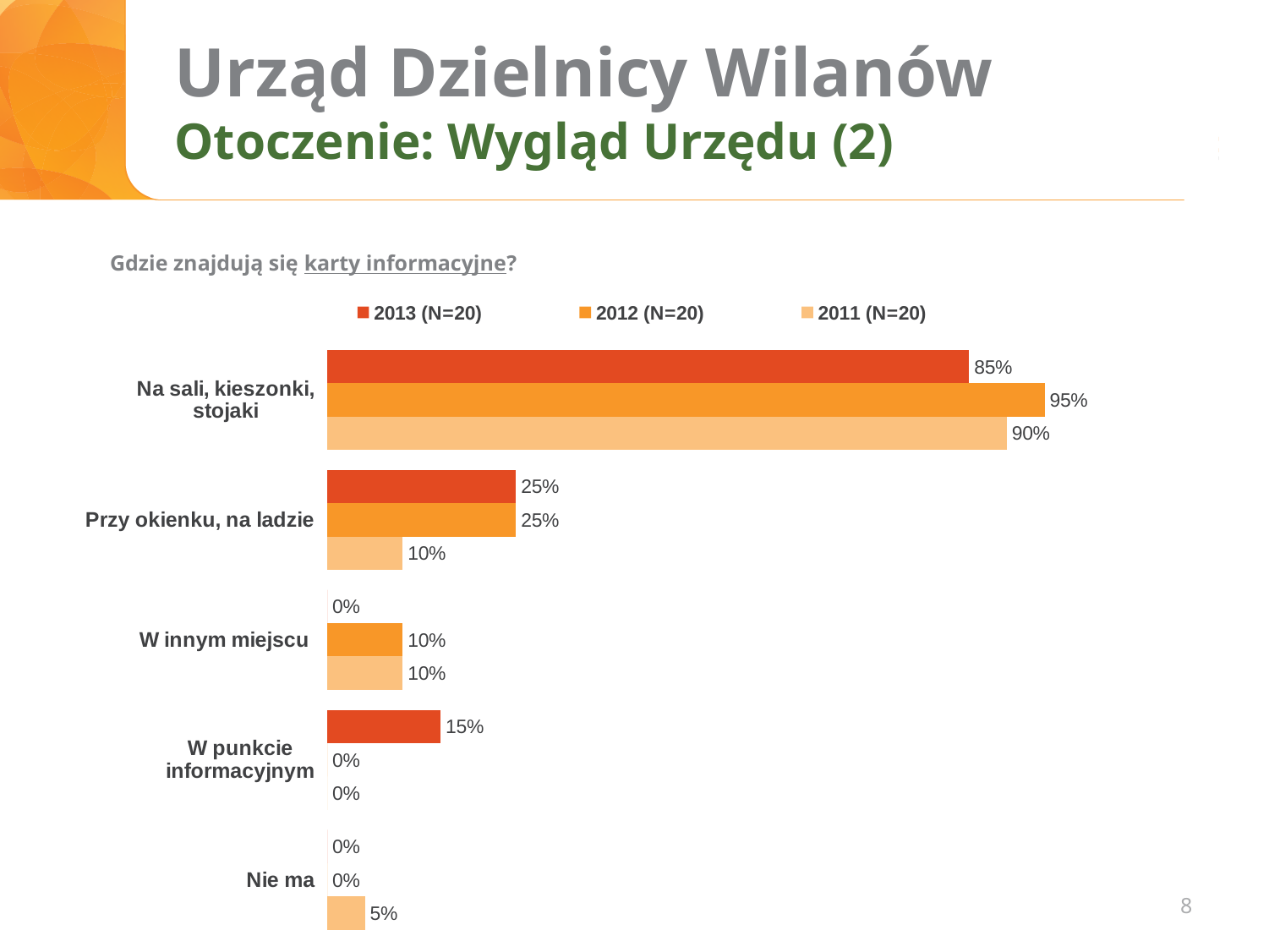
How many series does the legend list? 3 What is the value for "Nie ma" in the 2011 (N=20) series? 5% Which is larger for "Przy okienku, na ladzie": the 2013 (N=20) value or the 2011 (N=20) value? 2013 (N=20) What is the value for "W innym miejscu" in the 2013 (N=20) series? 0% What is the value for "W punkcie informacyjnym" in the 2013 (N=20) series? 15% What kind of chart is shown on the slide? Bar chart What is the difference between the 2012 (N=20) and 2013 (N=20) values for "Na sali, kieszonki, stojaki"? 10% What question does the chart answer, according to the text above it? Gdzie znajdują się karty informacyjne? What is the value for "Na sali, kieszonki, stojaki" in the 2013 (N=20) series? 85% How many categories are shown on the chart? 5 What is the value for "Przy okienku, na ladzie" in the 2011 (N=20) series? 10% Which category has the highest value in the 2012 (N=20) series? Na sali, kieszonki, stojaki